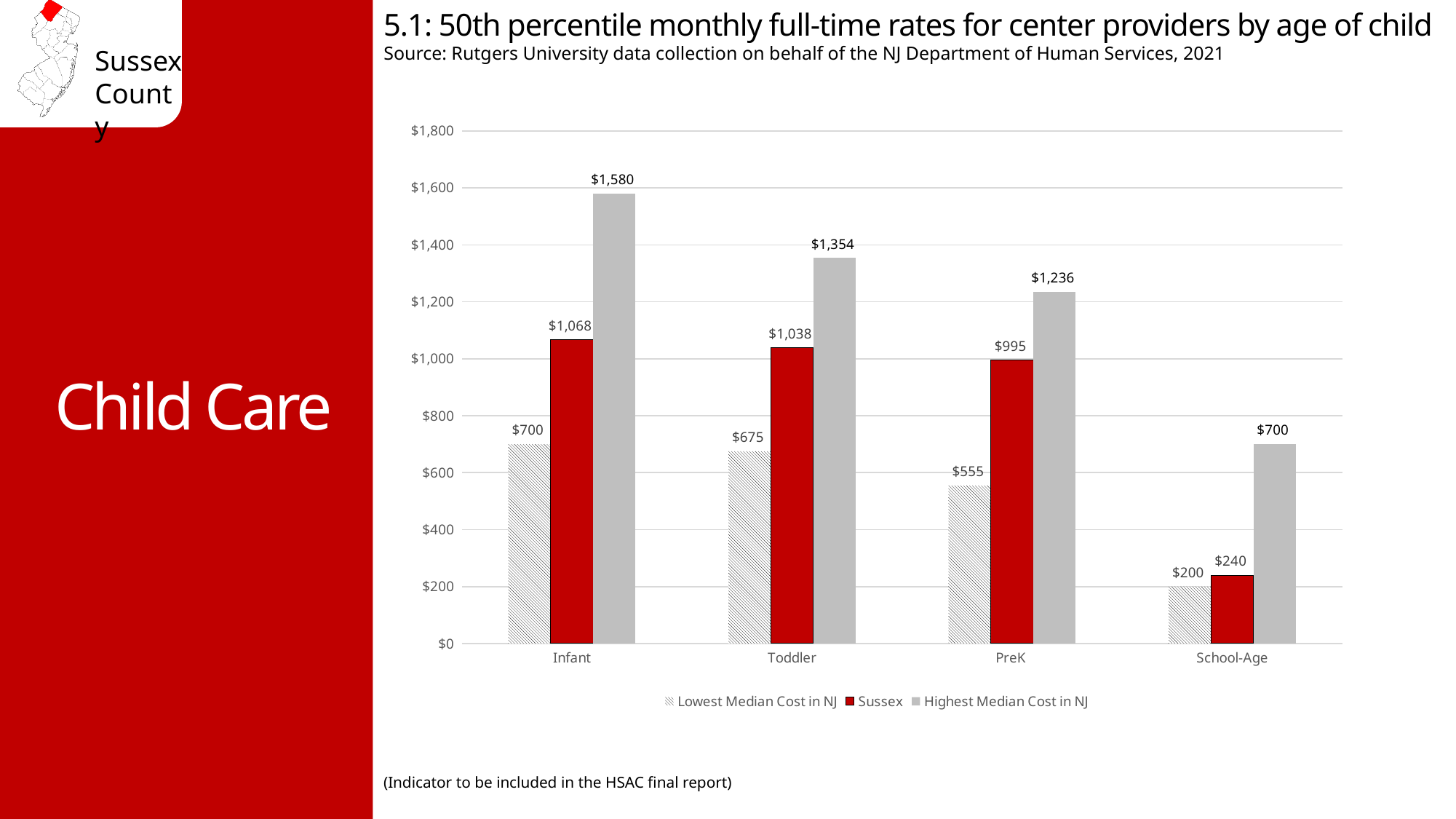
Which age category has the lowest Highest Median Cost in NJ value? School-Age What is the Sussex value for Infant? $1,068 How many series does the legend list? 3 Which is larger for Toddler: the Sussex value or the Lowest Median Cost in NJ? Sussex What is the difference between the Highest Median Cost in NJ and the Sussex value for Infant? $512 Which age category has the highest Sussex value? Infant What is the Sussex value for School-Age? $240 What kind of chart is shown? Bar chart What is the Highest Median Cost in NJ for Toddler? $1,354 How many age categories are shown on the x axis? 4 What is the Lowest Median Cost in NJ for PreK? $555 Do the Sussex values rise or fall from Infant to School-Age? Fall